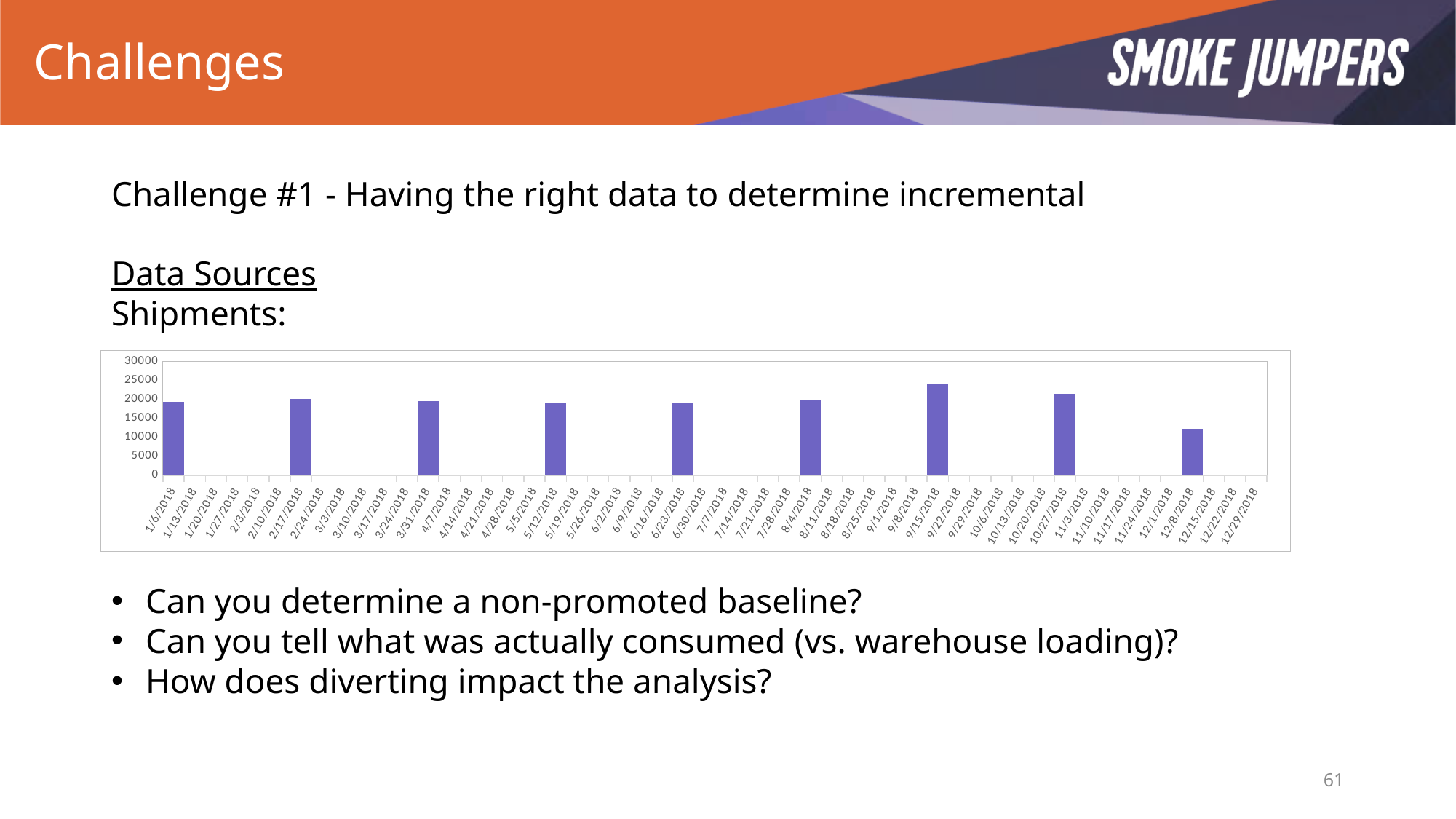
Which is larger, the value for 9/15/2018 or the value for 10/27/2018? 9/15/2018 What is the highest value shown on the vertical axis of the chart? 30000 Which is larger, the value for 9/15/2018 or the value for 12/8/2018? 9/15/2018 How many dates in the chart have a visible (non-zero) bar? 9 What colour are the bars in the chart? purple Is the value for 12/8/2018 greater or less than 15000? less Which date has the highest shipment value in the chart? 9/15/2018 What kind of chart is shown on the slide? bar chart Is the value for 9/15/2018 greater or less than 20000? greater Is the value for 12/8/2018 greater or less than 10000? greater Among the dates with a visible bar, which has the lowest shipment value? 12/8/2018